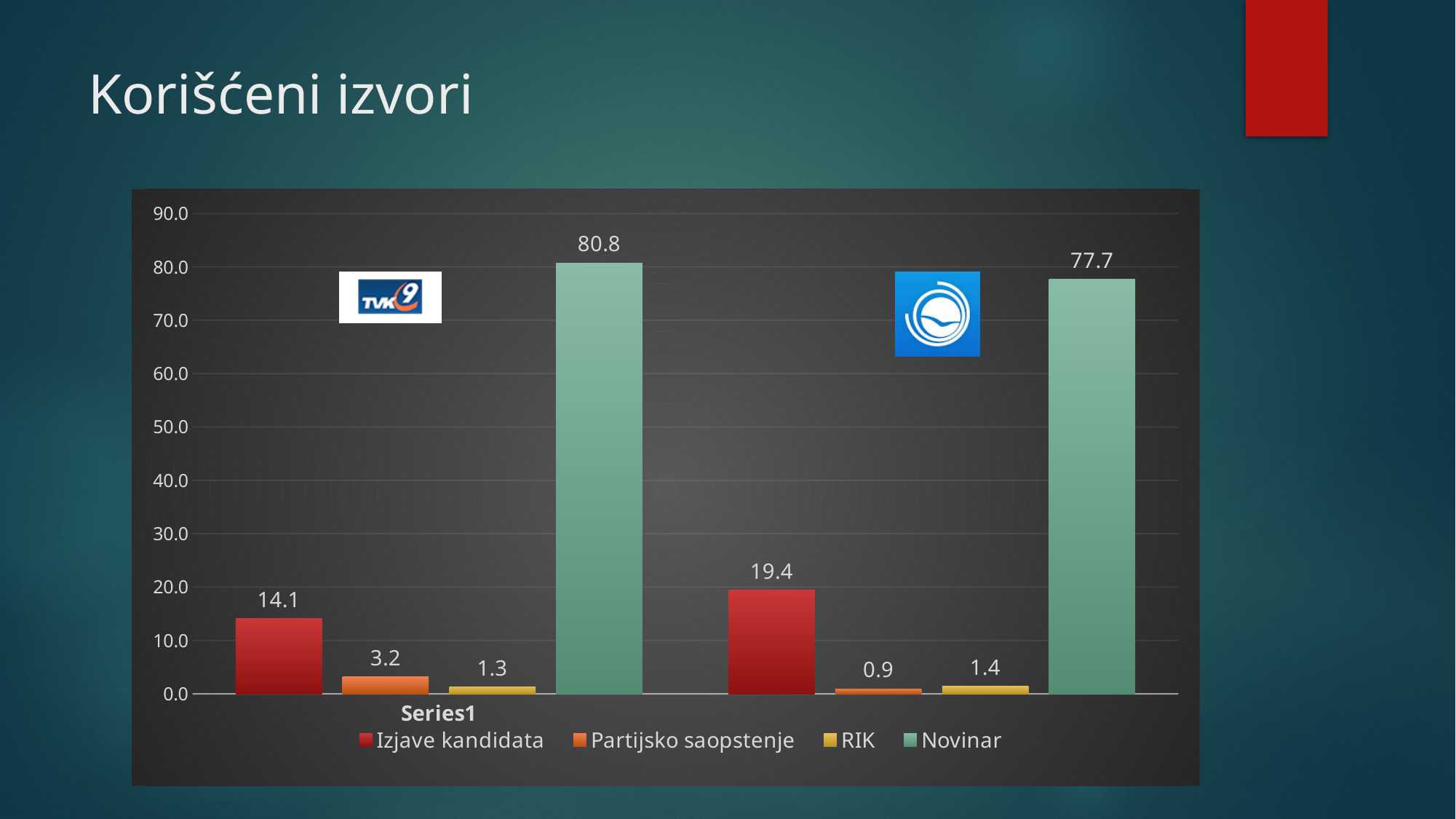
What is the difference between the Novinar values in the left group (80.8) and the right group (77.7)? 3.1 What is the difference between the Izjave kandidata value (14.1) and the Partijsko saopstenje value (3.2) in the left group? 10.9 What is the title of the slide? Korišćeni izvori What is the value of the Izjave kandidata bar in the right group of bars? 19.4 What kind of chart is shown on the slide? bar chart What is the value of the RIK bar in the right group of bars? 1.4 Which series has the highest value in the left group of bars? Novinar How many series does the legend list? 4 What is the value of the Novinar bar in the left group of bars? 80.8 Which is larger: the Izjave kandidata value in the left group or in the right group? right group (19.4) What is the value of the Partijsko saopstenje bar in the left group of bars? 3.2 Which series has the lowest value in the right group of bars? Partijsko saopstenje